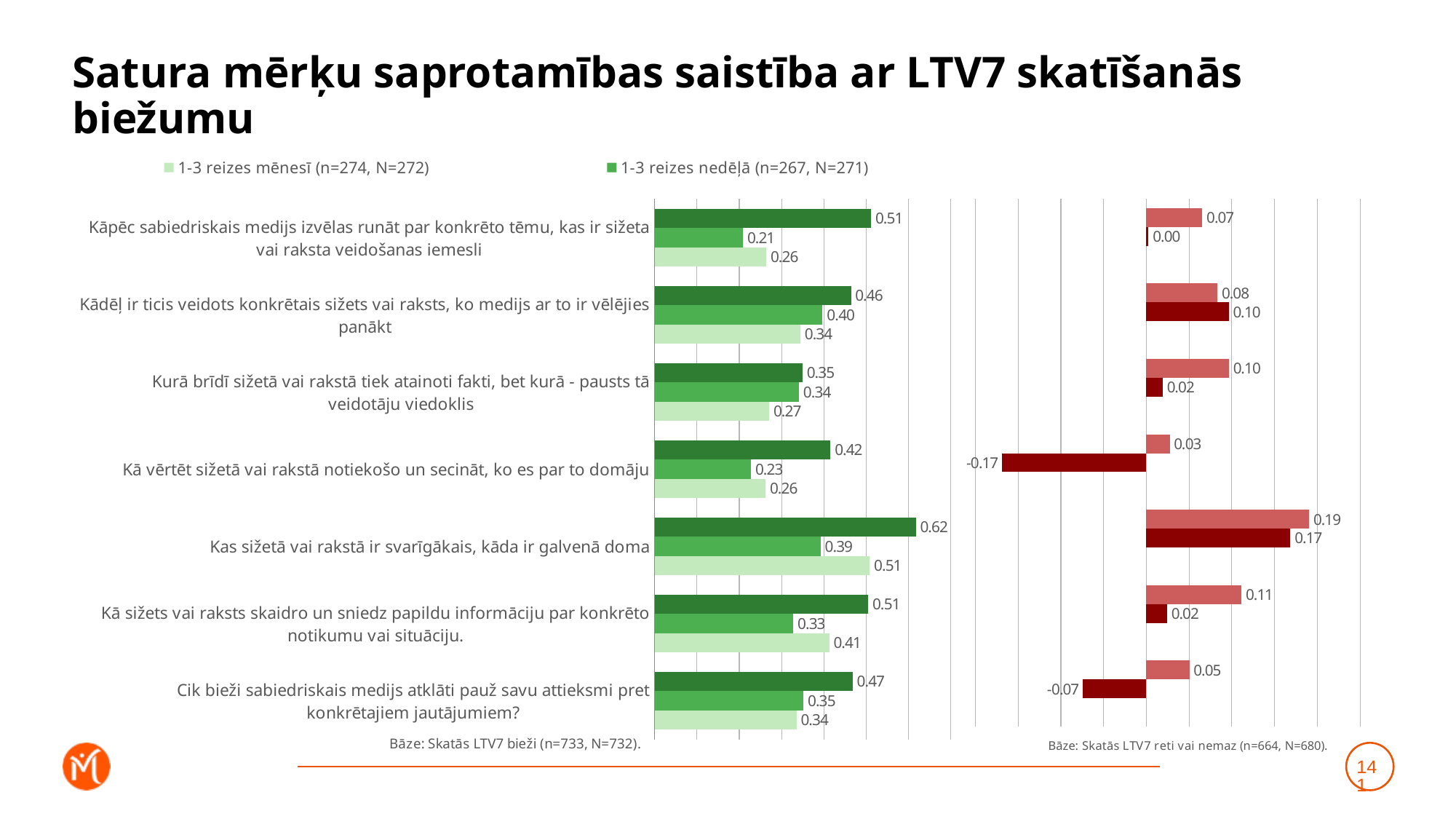
In the left chart, what is the value of the '1-3 reizes mēnesī' series for 'Kurā brīdī sižetā vai rakstā tiek atainoti fakti, bet kurā - pausts tā viedotāju viedoklis'? 0.27 What type of chart is used on this slide? Bar chart In the left chart, what is the value of the '1-3 reizes nedēļā' series for 'Kādēļ ir ticis veidots konkrētais sižets vai raksts, ko medijs ar to ir vēlējies panākt'? 0.40 How many series does the legend above the charts list? 2 What is the highest value shown in the left chart? 0.62 In the right chart, what is the value of the darker red bar for 'Kas sižetā vai rakstā ir svarīgākais, kāda ir galvenā doma'? 0.17 What is the lowest value shown in the right chart? -0.17 In the left chart, what is the difference between the '1-3 reizes mēnesī' value (0.41) and the '1-3 reizes nedēļā' value (0.33) for 'Kā sižets vai raksts skaidro un sniedz papildu informāciju par konkrēto notikumu vai situāciju.'? 0.08 In the left chart, which is larger for 'Kā vērtēt sižetā vai rakstā notiekošo un secināt, ko es par to domāju': the '1-3 reizes mēnesī' value or the '1-3 reizes nedēļā' value? 1-3 reizes mēnesī In the left chart, what is the value of the '1-3 reizes mēnesī' series for 'Kas sižetā vai rakstā ir svarīgākais, kāda ir galvenā doma'? 0.51 What base (Bāze) is stated below the left chart? Skatās LTV7 bieži (n=733, N=732). How many categories (questions) are listed on the left chart? 7